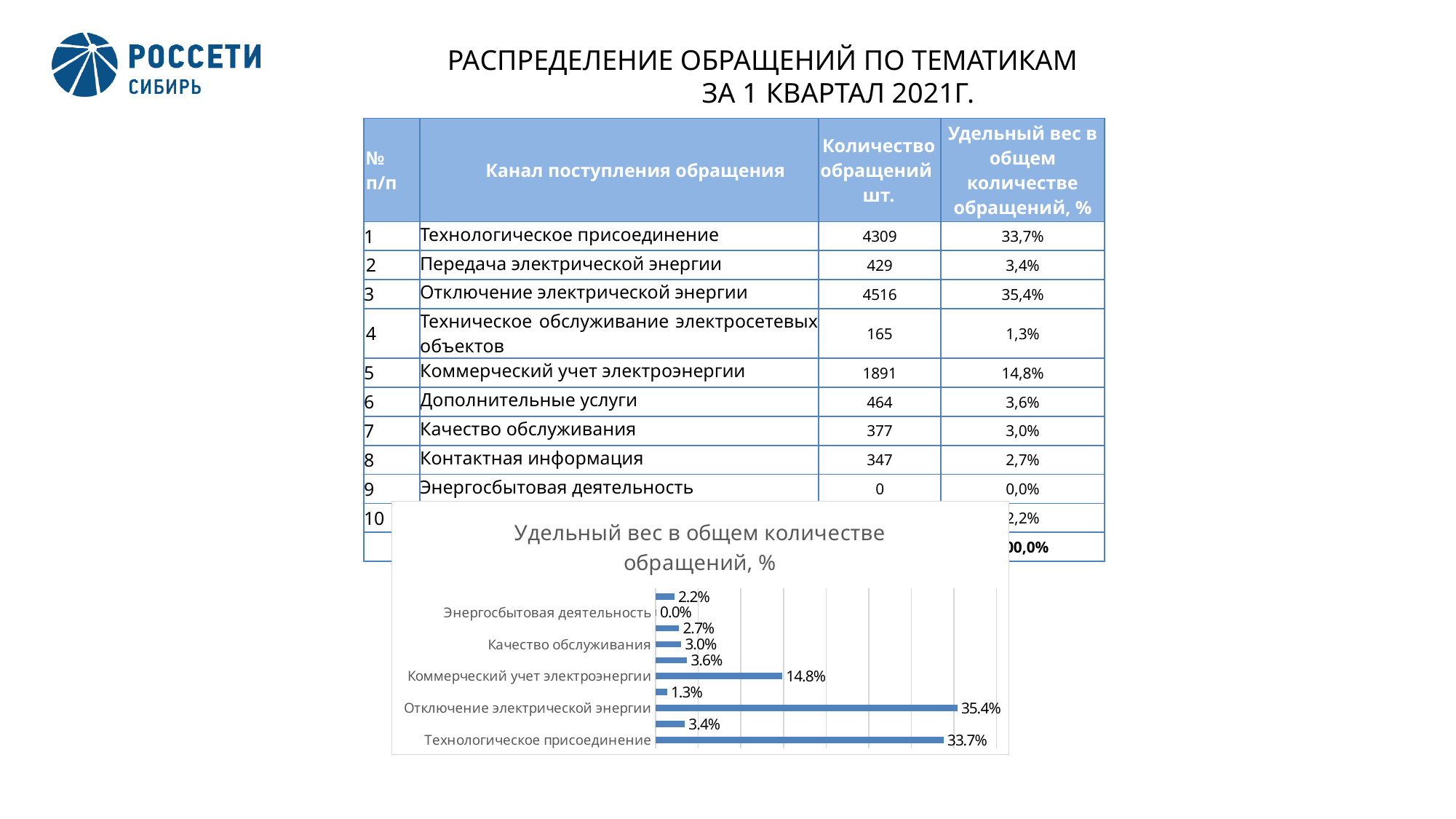
What value does the chart show for Качество обслуживания? 3.0% What is the difference between the values for Отключение электрической энергии and Технологическое присоединение? 1.7% Which is larger: the value for Коммерческий учет электроэнергии or the value for Качество обслуживания? Коммерческий учет электроэнергии Which category has the highest value in the chart? Отключение электрической энергии What is the title of the chart? Удельный вес в общем количестве обращений, % What value does the chart show for Отключение электрической энергии? 35.4% Which category has the lowest value in the chart? Энергосбытовая деятельность What value does the chart show for Технологическое присоединение? 33.7% What value does the chart show for Коммерческий учет электроэнергии? 14.8% How many bars are plotted in the chart? 10 What value does the chart show for Энергосбытовая деятельность? 0.0% What kind of chart is shown on the slide? Bar chart